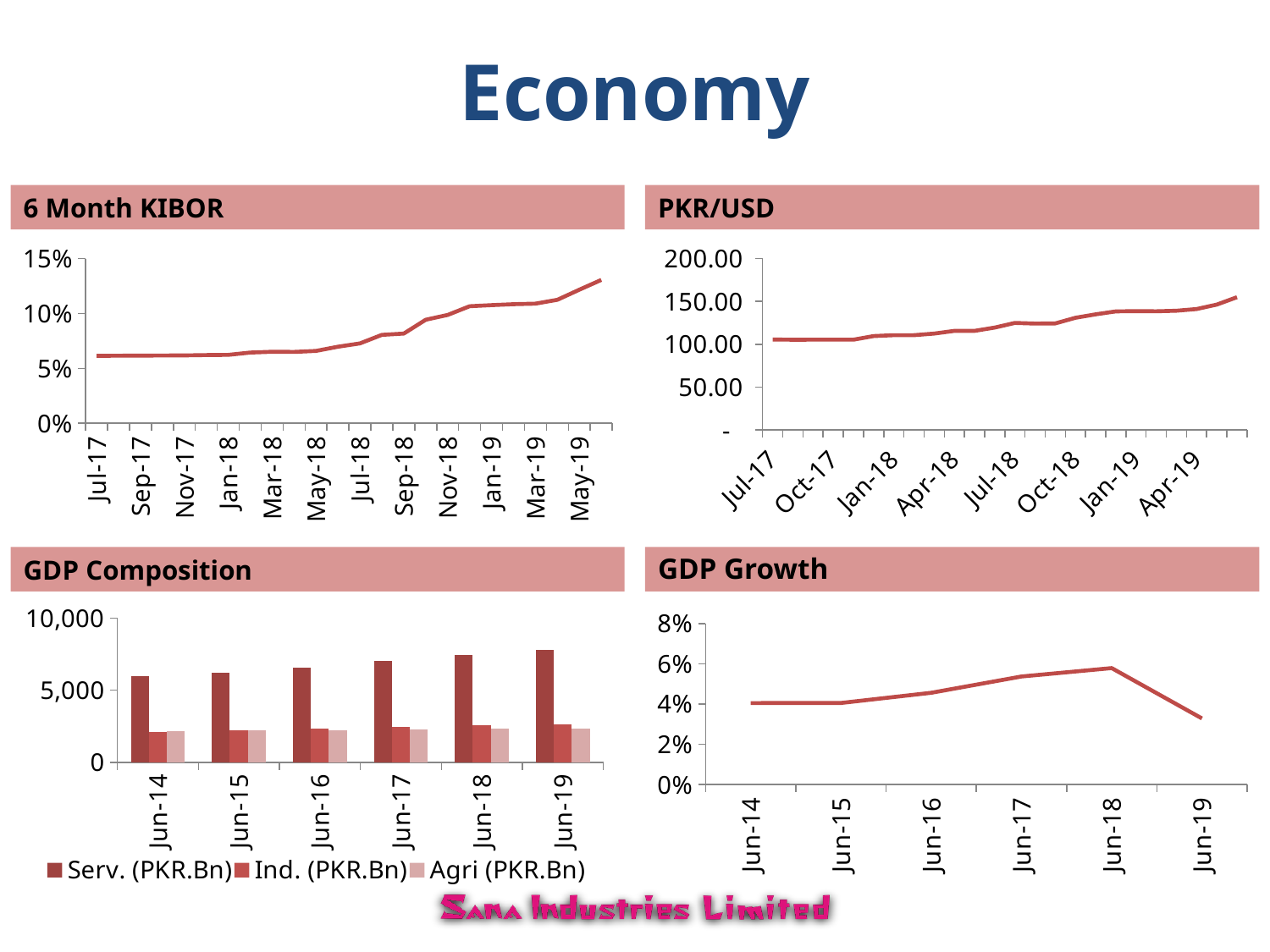
In the GDP Composition chart, is the Serv. (PKR.Bn) value for Jun-19 greater or less than 5,000? greater What kind of chart is the 6 Month KIBOR chart? line chart What kind of chart is the GDP Composition chart? bar chart How many series does the legend of the GDP Composition chart list? 3 In the GDP Composition chart, which series has the tallest bar in Jun-19? Serv. (PKR.Bn) In the 6 Month KIBOR chart, do the values rise or fall from Jul-17 to May-19? rise In the 6 Month KIBOR chart, is the last plotted value (after May-19) greater or less than 10%? greater In the 6 Month KIBOR chart, is the value at Jul-17 greater or less than 10%? less In the PKR/USD chart, do the values rise or fall over the period shown? rise In the GDP Growth chart, which period has the highest value? Jun-18 How many periods are shown on the x axis of the GDP Composition chart? 6